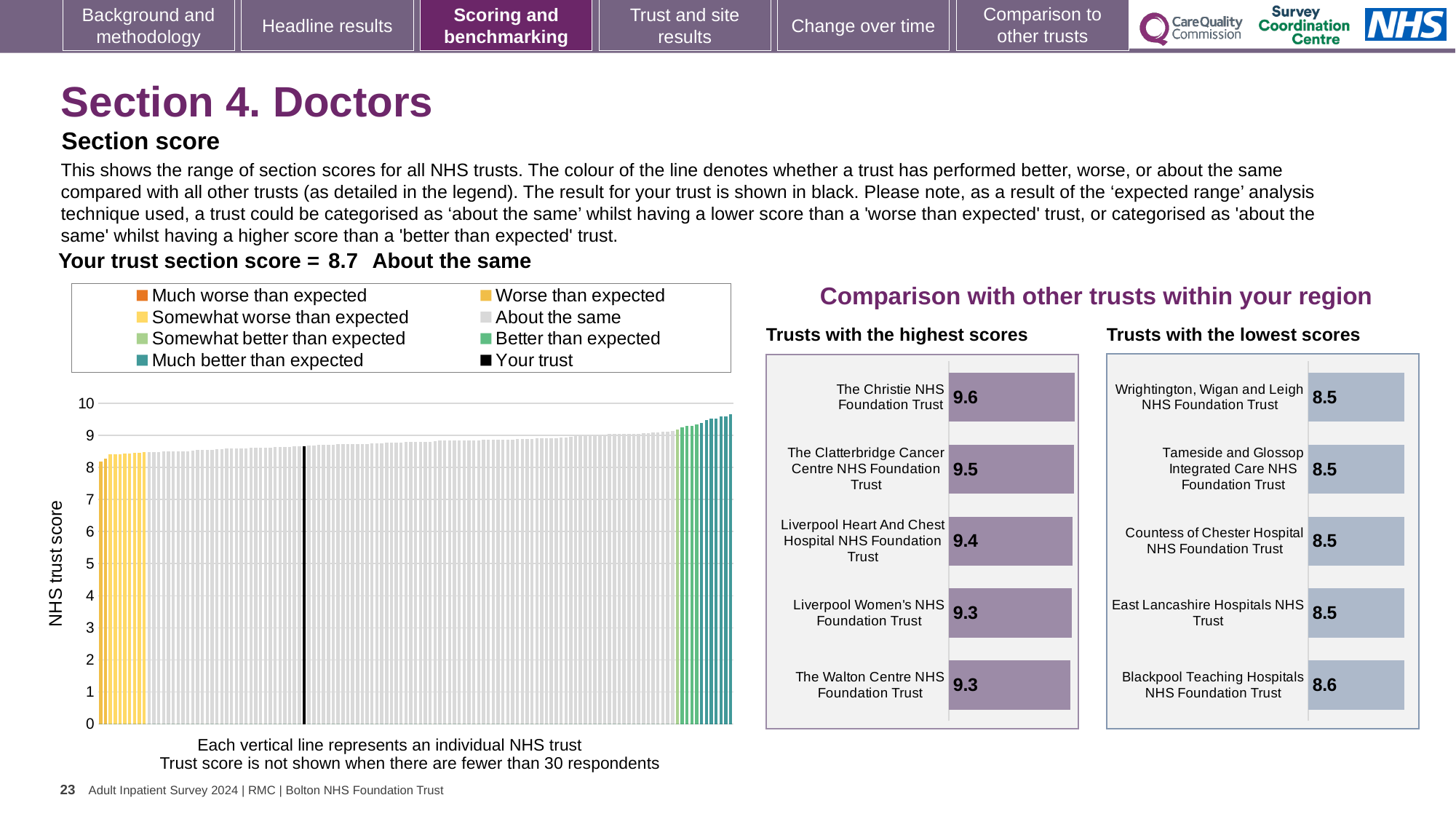
In the 'NHS trust score' chart on the left, is the value for the black 'Your trust' bar greater or less than 5? greater In the 'Trusts with the highest scores' chart, which trust has the highest score? The Christie NHS Foundation Trust How many trusts are shown in the 'Trusts with the lowest scores' chart? 5 How many entries does the legend of the 'NHS trust score' chart on the left list? 8 How many trusts are shown in the 'Trusts with the highest scores' chart? 5 In the 'Trusts with the highest scores' chart, what is the difference between the scores of The Christie NHS Foundation Trust and The Walton Centre NHS Foundation Trust? 0.3 In the 'Trusts with the highest scores' chart, what is the score for Liverpool Heart And Chest Hospital NHS Foundation Trust? 9.4 In the 'Trusts with the highest scores' chart, which has the larger score: The Clatterbridge Cancer Centre NHS Foundation Trust or Liverpool Women's NHS Foundation Trust? The Clatterbridge Cancer Centre NHS Foundation Trust In the 'Trusts with the lowest scores' chart, what is the score for Blackpool Teaching Hospitals NHS Foundation Trust? 8.6 In the 'Trusts with the lowest scores' chart, which trust has the highest score? Blackpool Teaching Hospitals NHS Foundation Trust What kind of chart is the large 'NHS trust score' chart on the left of the slide? bar chart In the 'Trusts with the highest scores' chart, what is the score for The Christie NHS Foundation Trust? 9.6